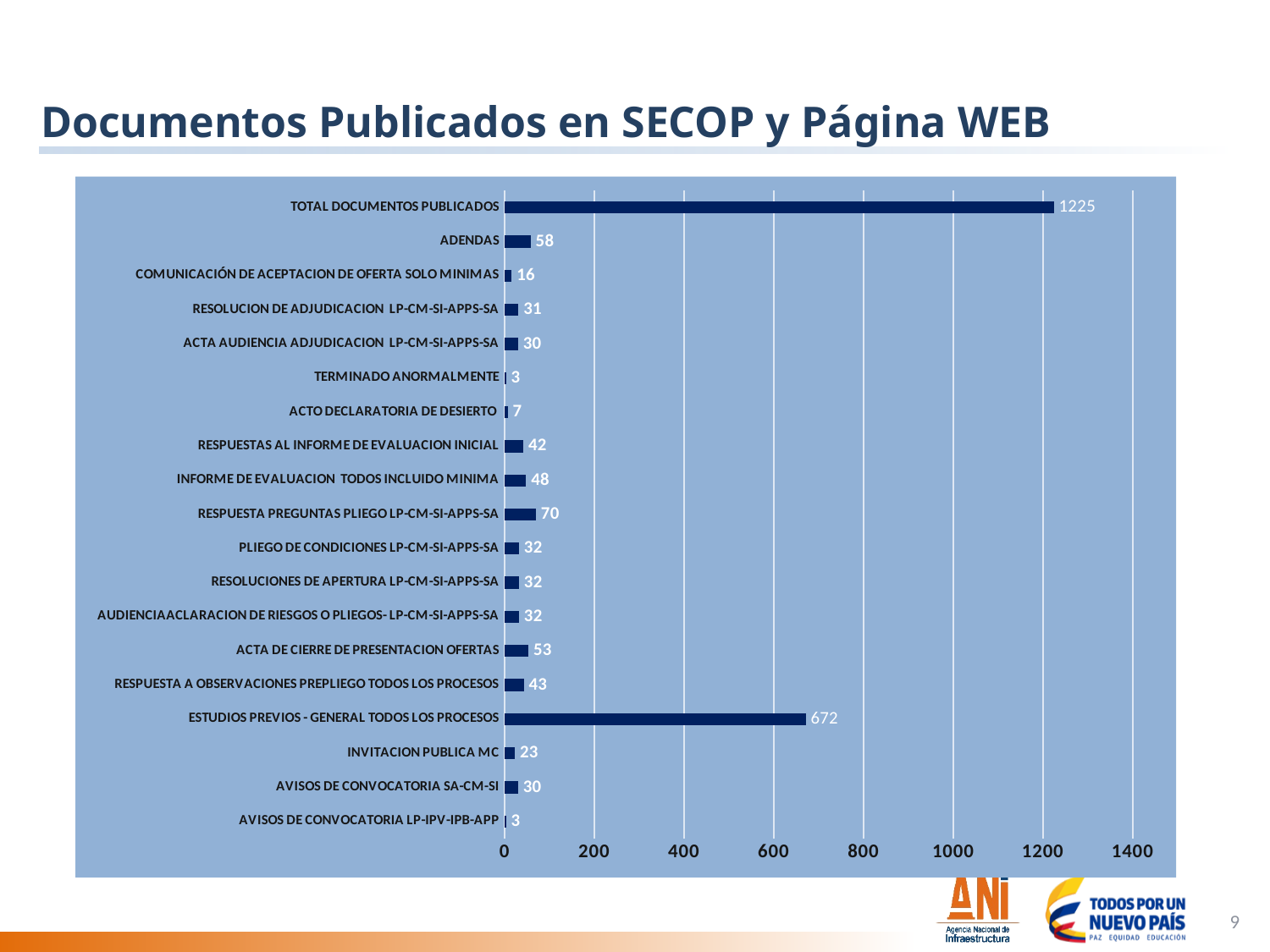
What is the title of the slide? Documentos Publicados en SECOP y Página WEB Which category has the highest value? TOTAL DOCUMENTOS PUBLICADOS What is the value for INVITACION PUBLICA MC? 23 What is the value for ADENDAS? 58 What is the lowest value shown in the chart? 3 What is the value for RESPUESTA PREGUNTAS PLIEGO LP-CM-SI-APPS-SA? 70 What is the difference between TOTAL DOCUMENTOS PUBLICADOS and ESTUDIOS PREVIOS - GENERAL TODOS LOS PROCESOS? 553 What is the value for TOTAL DOCUMENTOS PUBLICADOS? 1225 What is the value for ESTUDIOS PREVIOS - GENERAL TODOS LOS PROCESOS? 672 Which is larger, ACTA DE CIERRE DE PRESENTACION OFERTAS or RESPUESTA A OBSERVACIONES PREPLIEGO TODOS LOS PROCESOS? ACTA DE CIERRE DE PRESENTACION OFERTAS How many categories are shown in the chart? 19 What type of chart is shown on the slide? bar chart